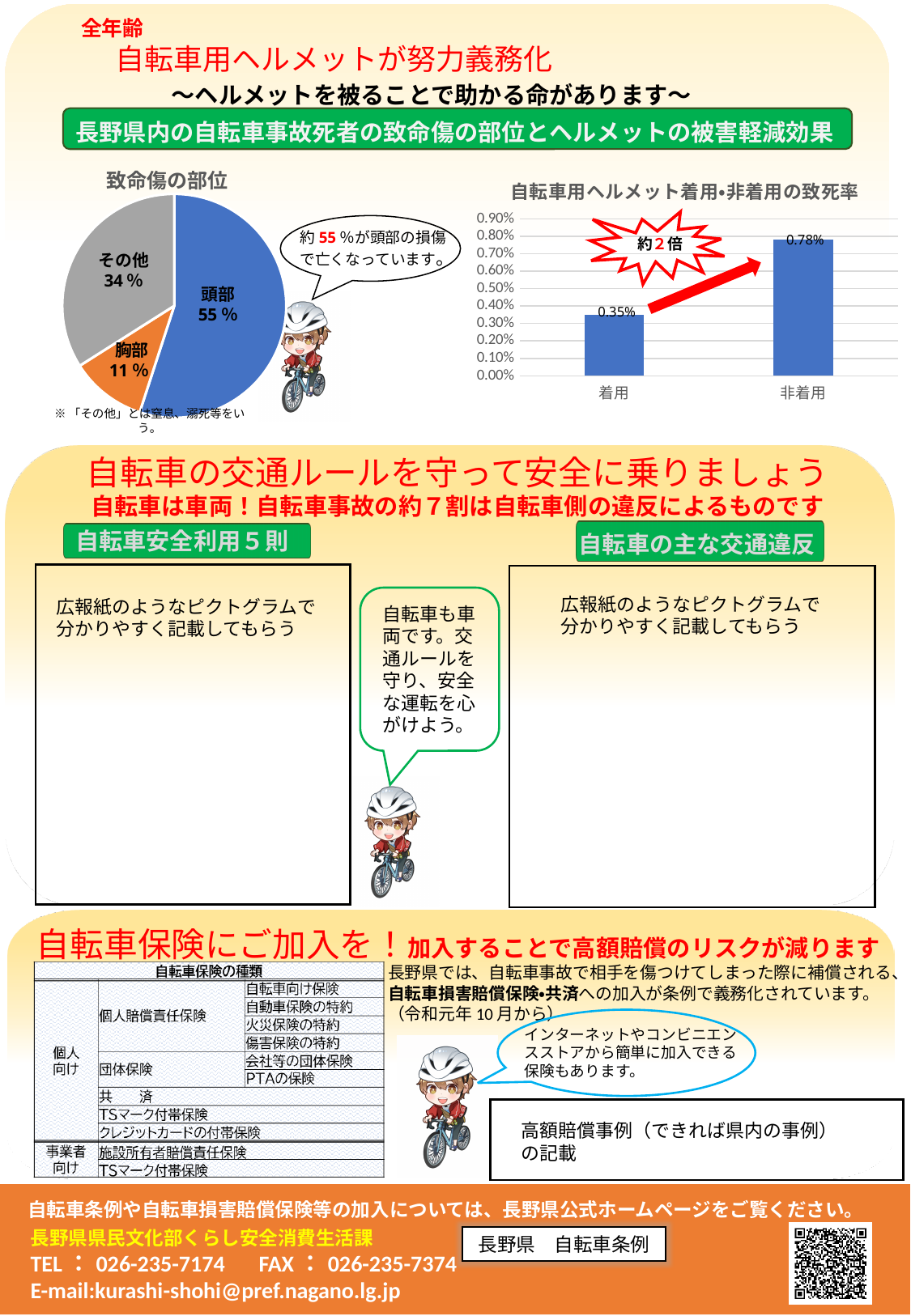
In the pie chart titled 致命傷の部位, which category has the largest slice? 頭部 In the pie chart titled 致命傷の部位, what share is shown for その他? 34 % In the bar chart titled 自転車用ヘルメット着用・非着用の致死率, what is the value for 非着用? 0.78% In the pie chart titled 致命傷の部位, what share is shown for 胸部? 11 % What kind of chart is the one titled 自転車用ヘルメット着用・非着用の致死率? bar chart In the bar chart titled 自転車用ヘルメット着用・非着用の致死率, which category has the higher value, 着用 or 非着用? 非着用 In the bar chart titled 自転車用ヘルメット着用・非着用の致死率, what is the value for 着用? 0.35% In the pie chart titled 致命傷の部位, how many slices are there? 3 In the pie chart titled 致命傷の部位, what is the difference in percentage points between 頭部 and その他? 21 In the bar chart titled 自転車用ヘルメット着用・非着用の致死率, is the value for 着用 greater or less than 0.40%? less In the pie chart titled 致命傷の部位, what share is shown for 頭部? 55 % In the pie chart titled 致命傷の部位, which category has the smallest slice? 胸部